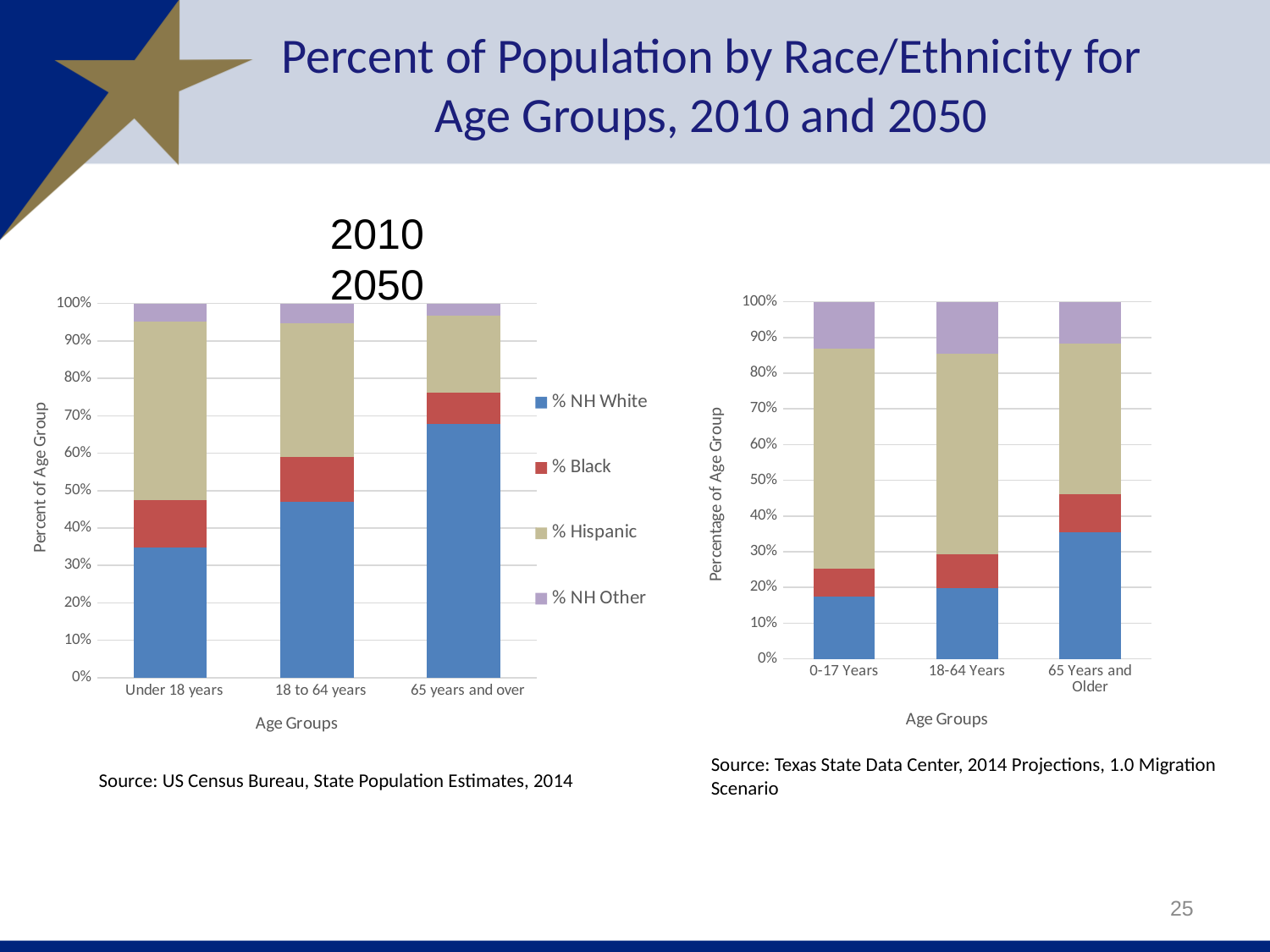
In the right chart, which age group has the smallest bottom (blue) segment? 0-17 Years In the left chart, is the % NH White value for 65 years and over greater or less than 60%? greater In the left chart, is the % NH White value for Under 18 years greater or less than 40%? less In the right chart, is the bottom (blue) segment for 65 Years and Older greater or less than 30%? greater What is the y-axis title of the right chart? Percentage of Age Group How many series does the legend of the left chart list? 4 What kind of chart is the left chart? stacked bar chart How many age groups are shown on the x axis of the right chart? 3 In the left chart, is the % NH White share larger for Under 18 years or for 18 to 64 years? 18 to 64 years In the left chart, which age group has the largest % NH White share? 65 years and over How many age groups are shown on the x axis of the left chart? 3